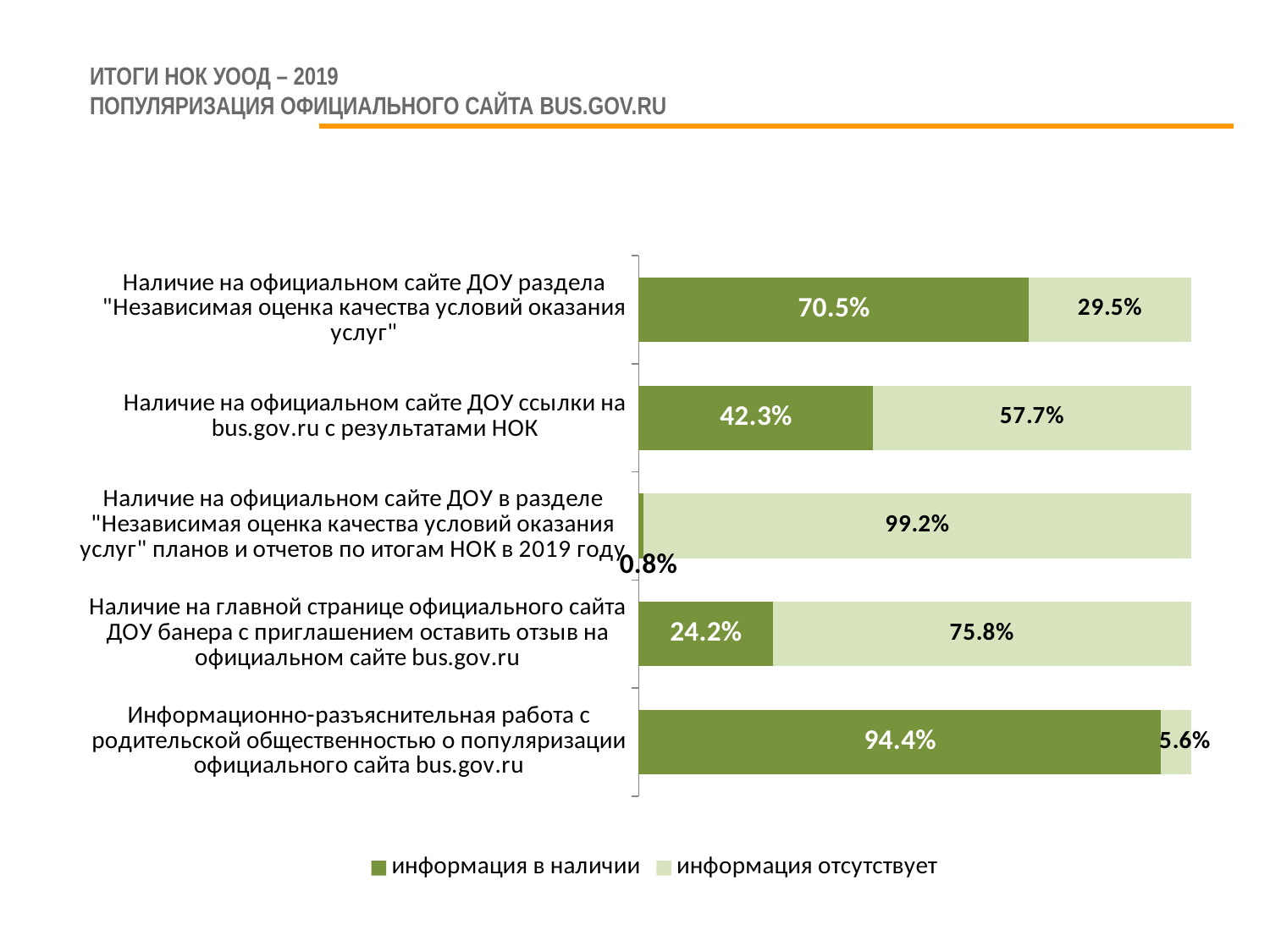
What is the difference between the "информация в наличии" values for "Наличие на официальном сайте ДОУ раздела "Независимая оценка качества условий оказания услуг"" and "Наличие на официальном сайте ДОУ ссылки на bus.gov.ru с результатами НОК"? 28.2 percentage points Which category has the highest value for "информация в наличии"? Информационно-разъяснительная работа с родительской общественностью о популяризации официального сайта bus.gov.ru How many series does the legend list? 2 What is the value of "информация в наличии" for "Наличие на официальном сайте ДОУ ссылки на bus.gov.ru с результатами НОК"? 42.3% How many categories are plotted in the chart? 5 Which category has the lowest value for "информация в наличии"? Наличие на официальном сайте ДОУ в разделе "Независимая оценка качества условий оказания услуг" планов и отчетов по итогам НОК в 2019 году What type of chart is shown on the slide? Stacked bar chart What is the value of "информация в наличии" for "Информационно-разъяснительная работа с родительской общественностью о популяризации официального сайта bus.gov.ru"? 94.4% Which series is shown in dark green in the chart? информация в наличии What is the total of the stacked bar for "Наличие на главной странице официального сайта ДОУ банера с приглашением оставить отзыв на официальном сайте bus.gov.ru"? 100% What is the value of "информация отсутствует" for "Наличие на главной странице официального сайта ДОУ банера с приглашением оставить отзыв на официальном сайте bus.gov.ru"? 75.8% Which is larger: the "информация отсутствует" value for "Наличие на официальном сайте ДОУ ссылки на bus.gov.ru с результатами НОК" or for "Наличие на официальном сайте ДОУ раздела "Независимая оценка качества условий оказания услуг""? Наличие на официальном сайте ДОУ ссылки на bus.gov.ru с результатами НОК